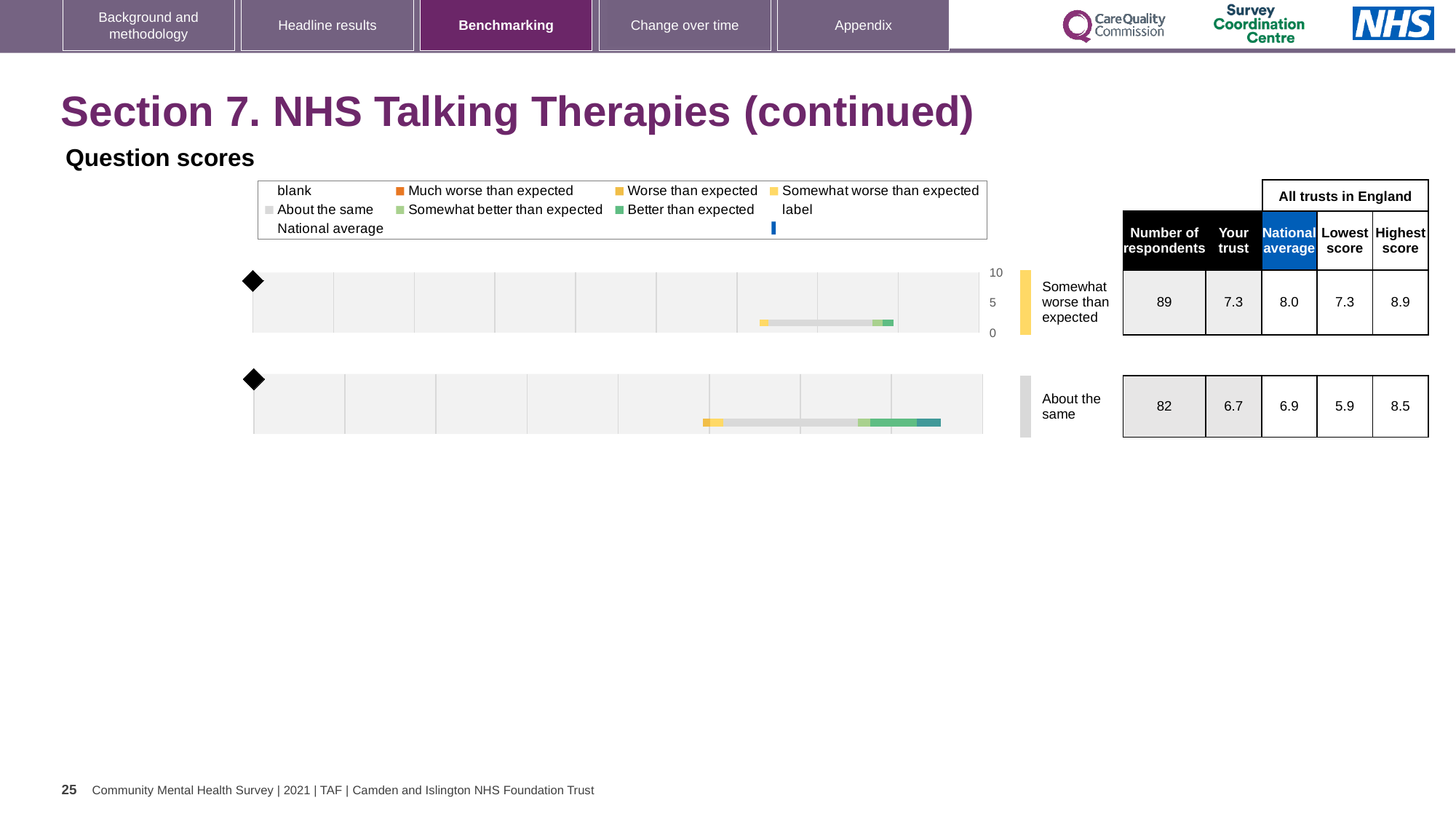
What benchmark category label is shown beside the bottom chart? About the same For the bottom chart (About the same), how many respondents are listed in the table? 82 What kind of chart is the top chart on the slide? bar chart For the bottom chart (About the same), what is the lowest score among all trusts in England? 5.9 For the top chart (Somewhat worse than expected), what is the 'Your trust' score in the table? 7.3 What is the highest tick value shown on the axis of the top chart? 10 For the bottom chart (About the same), what is the difference between the national average and the 'Your trust' score? 0.2 What benchmark category label is shown beside the top chart? Somewhat worse than expected For the top chart (Somewhat worse than expected), what is the national average in the table? 8.0 In the legend, what colour represents 'Much worse than expected'? orange Which chart's row has the higher 'Your trust' score, the top chart or the bottom chart? top chart For the top chart (Somewhat worse than expected), what is the highest score among all trusts in England? 8.9